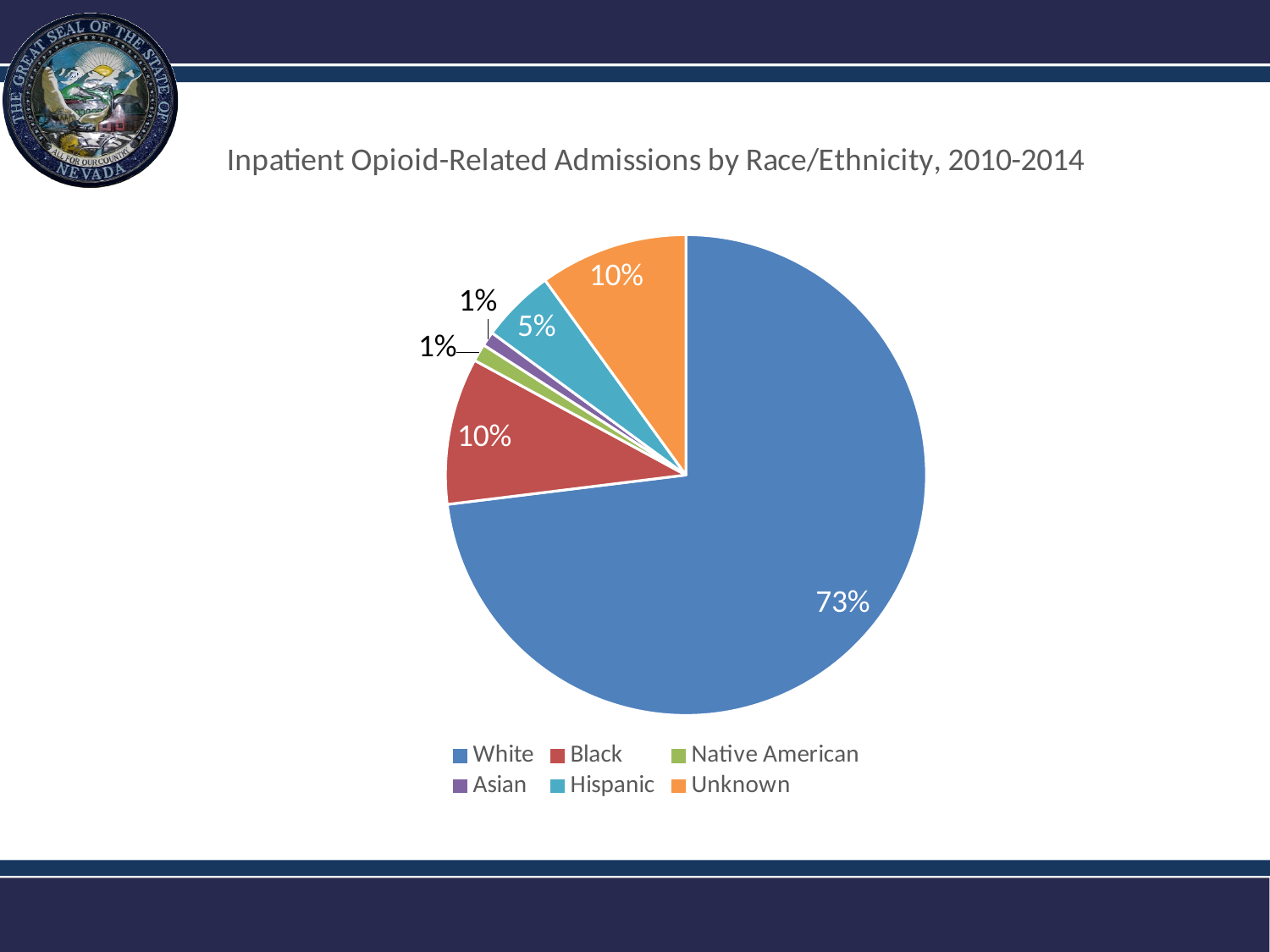
What is the difference in percentage points between the White share and the Black share? 63 What share of inpatient opioid-related admissions is Unknown? 10% Which is larger, the Hispanic share or the Unknown share? Unknown What kind of chart is shown on the slide? pie chart What is the title of the chart? Inpatient Opioid-Related Admissions by Race/Ethnicity, 2010-2014 What share of inpatient opioid-related admissions is Hispanic? 5% What is the difference in percentage points between the Hispanic share and the Native American share? 4 How many race/ethnicity categories does the legend list? 6 What share of inpatient opioid-related admissions is White? 73% Which race/ethnicity category has the largest share of admissions? White